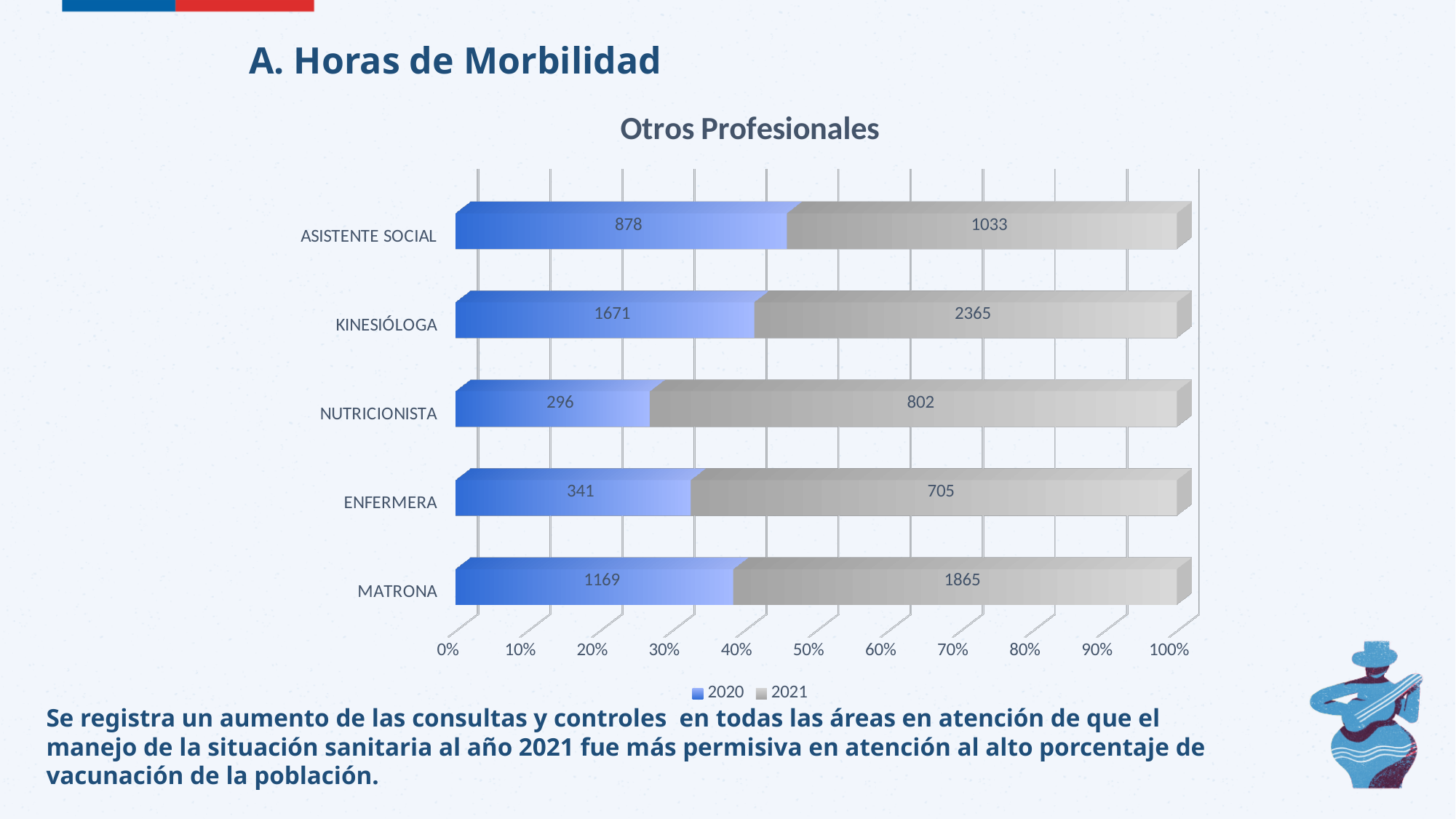
What is the 2021 value for MATRONA? 1865 What kind of chart is shown? Stacked bar chart How many series does the legend list? 2 What is the total of the 2020 and 2021 values for ASISTENTE SOCIAL? 1911 What is the title of the chart? Otros Profesionales What is the 2020 value for KINESIÓLOGA? 1671 What is the difference between the 2021 and 2020 values for ENFERMERA? 364 Which is larger: the 2020 value for ASISTENTE SOCIAL or the 2020 value for MATRONA? MATRONA How many categories are shown on the chart? 5 What is the 2021 value for NUTRICIONISTA? 802 Which category has the highest 2021 value? KINESIÓLOGA Which category has the lowest 2020 value? NUTRICIONISTA